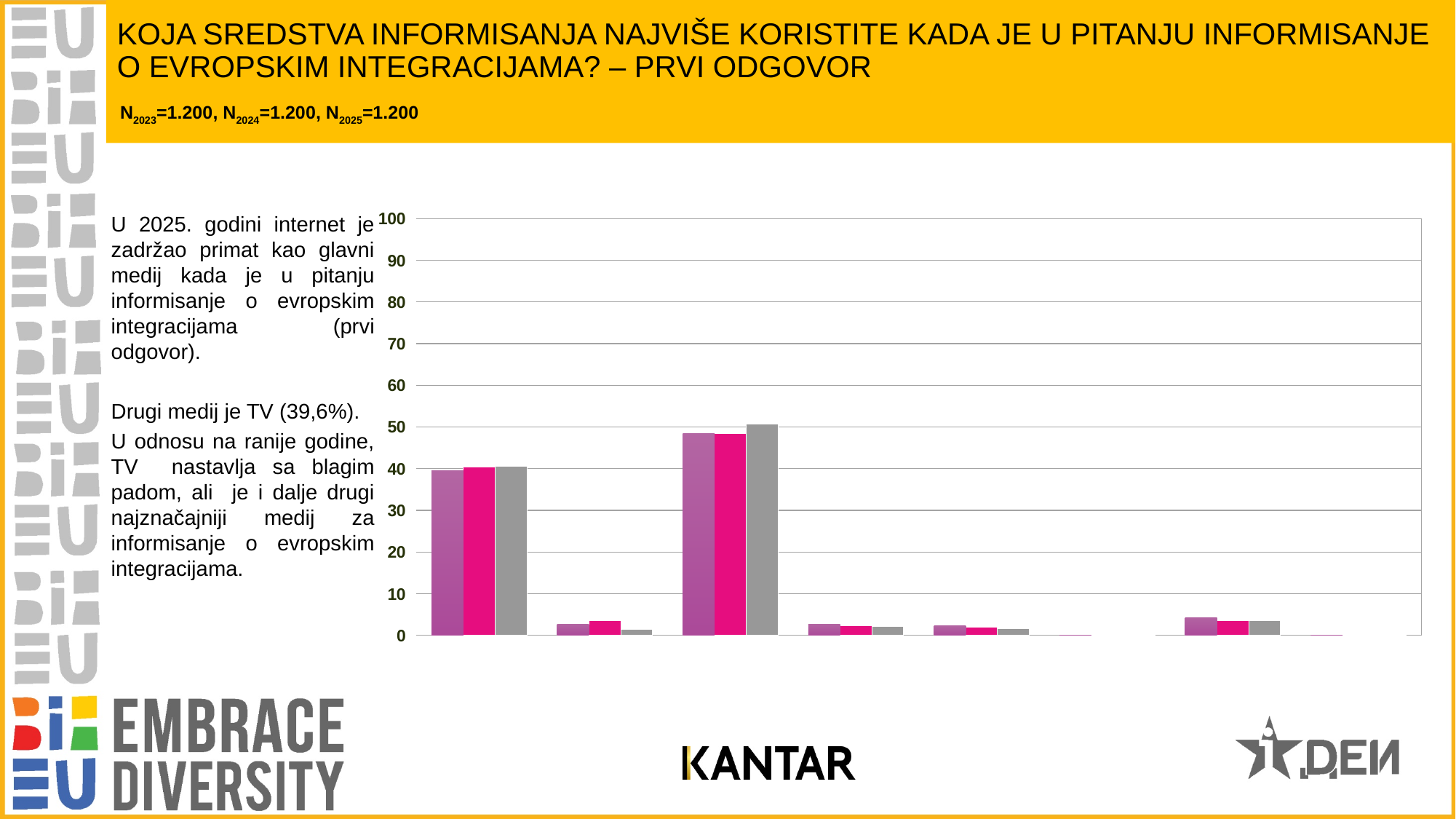
Are the values in the first group of bars from the left greater or less than 30? greater Are the values in the third group of bars from the left greater or less than 40? greater Are the values in the first group of bars from the left greater or less than 50? less Which group of bars on the chart is the tallest? the third group from the left What is the highest value shown on the chart's vertical axis? 100 What kind of chart is shown on the slide? bar chart How many bars are plotted in each group of bars on the chart? 3 Are the bars in the first group from the left taller or shorter than the bars in the third group from the left? shorter